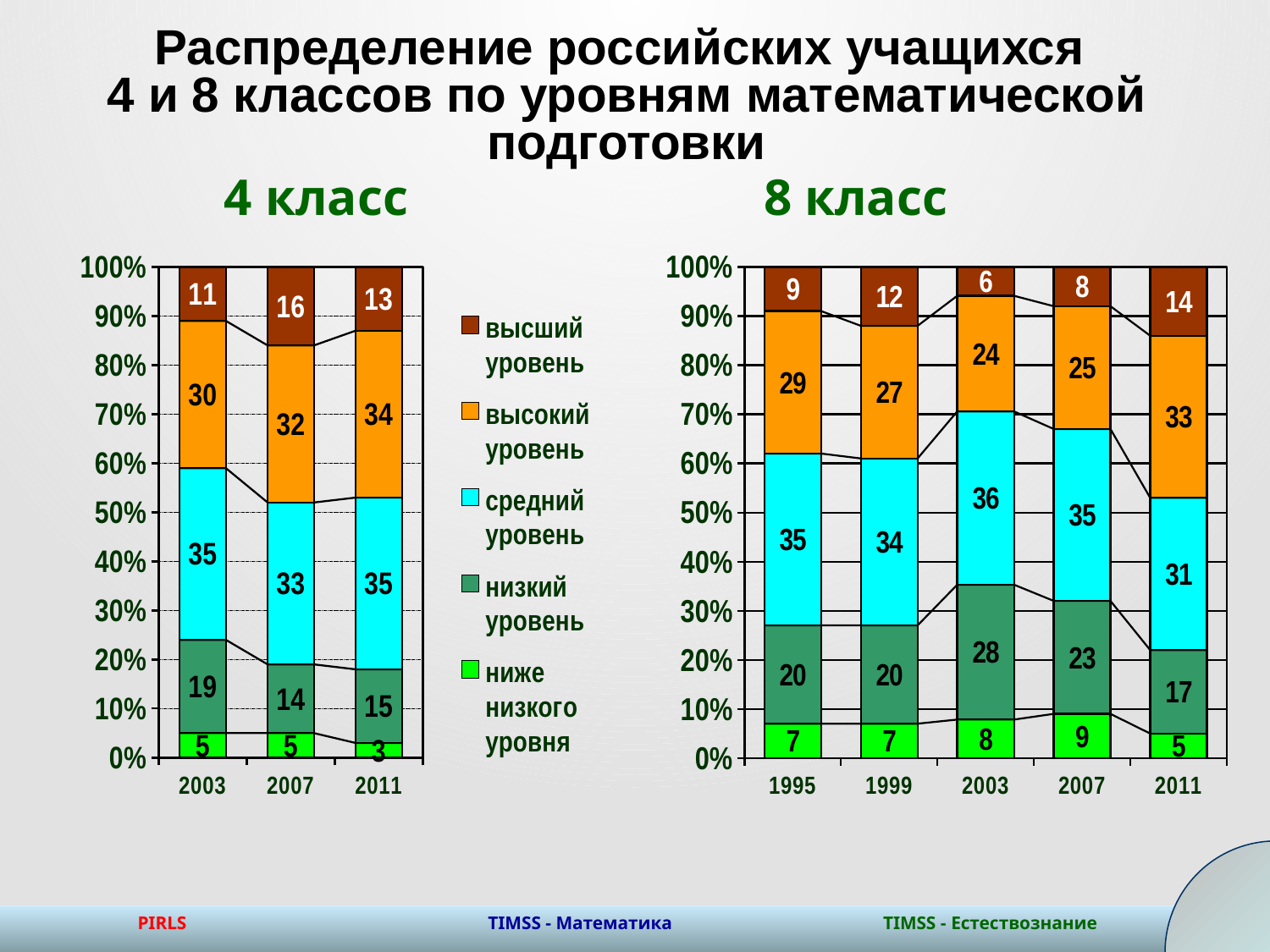
In the '8 класс' chart, what is the value for 'высокий уровень' in 2011? 33 In the '8 класс' chart, does the value for 'низкий уровень' rise or fall from 2003 to 2011? Fall Which legend entry is shown in orange? высокий уровень In the '8 класс' chart, what is the value for 'низкий уровень' in 2003? 28 How many years are shown on the x axis of the '8 класс' chart? 5 In the '8 класс' chart, which year has the highest value for 'высший уровень'? 2011 In the '4 класс' chart, which is larger: 'низкий уровень' in 2003 or in 2007? 2003 In the '8 класс' chart, what is the difference between the 'средний уровень' values for 2003 and 2011? 5 How many series does the legend list? 5 In the '4 класс' chart, which year has the lowest value for 'ниже низкого уровня'? 2011 What kind of chart is the '4 класс' chart? Stacked bar chart In the '4 класс' chart, what is the value for 'высший уровень' in 2007? 16